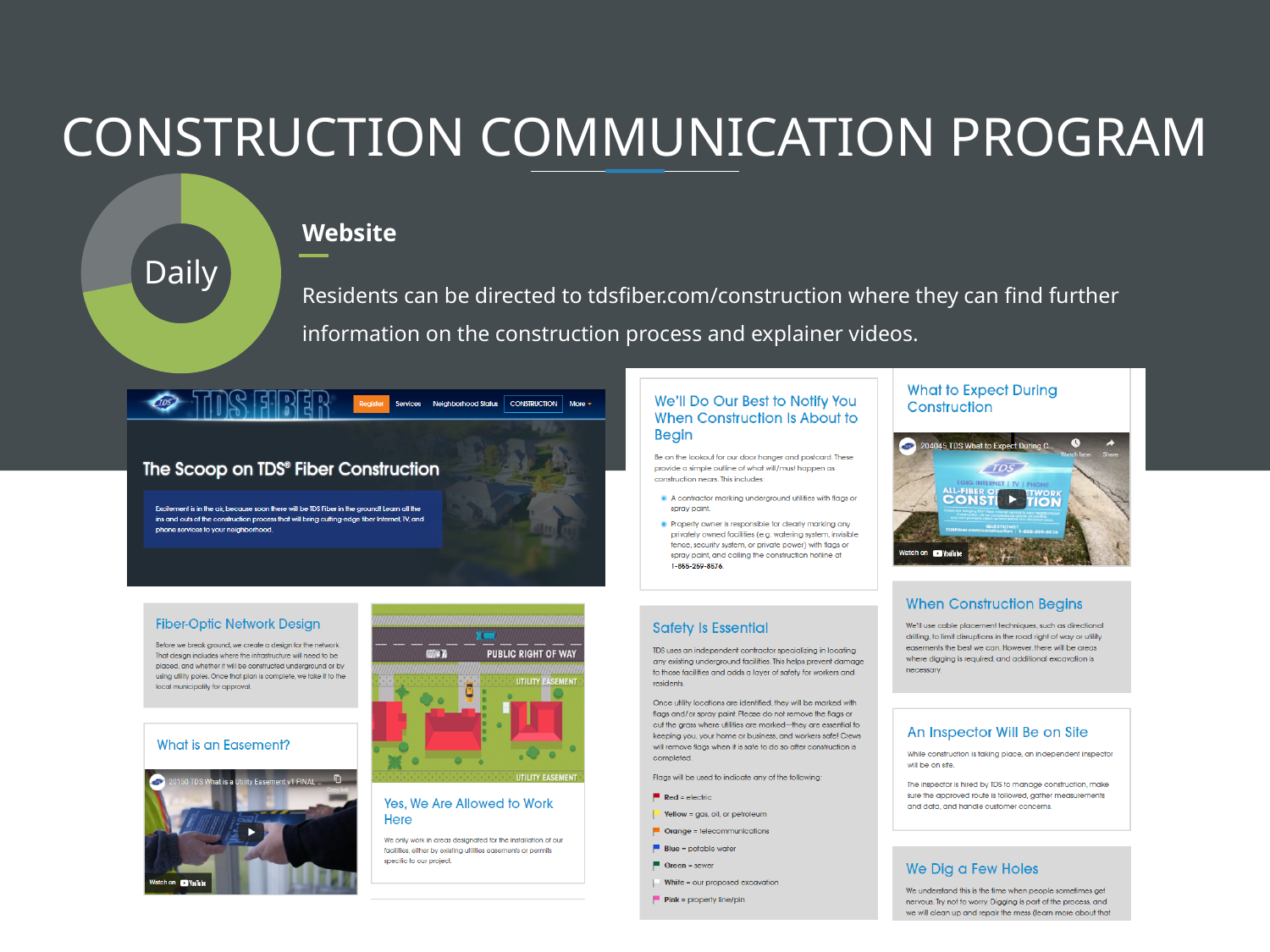
What two colours are used for the segments of the doughnut chart? Green and gray Which segment of the doughnut chart is larger, the green one or the gray one? Green How many segments does the doughnut chart have? 2 What kind of chart is shown on the left of the slide, next to the word "Website"? Doughnut chart Which segment of the doughnut chart is the smallest? The gray segment What word is printed in the centre of the doughnut chart? Daily